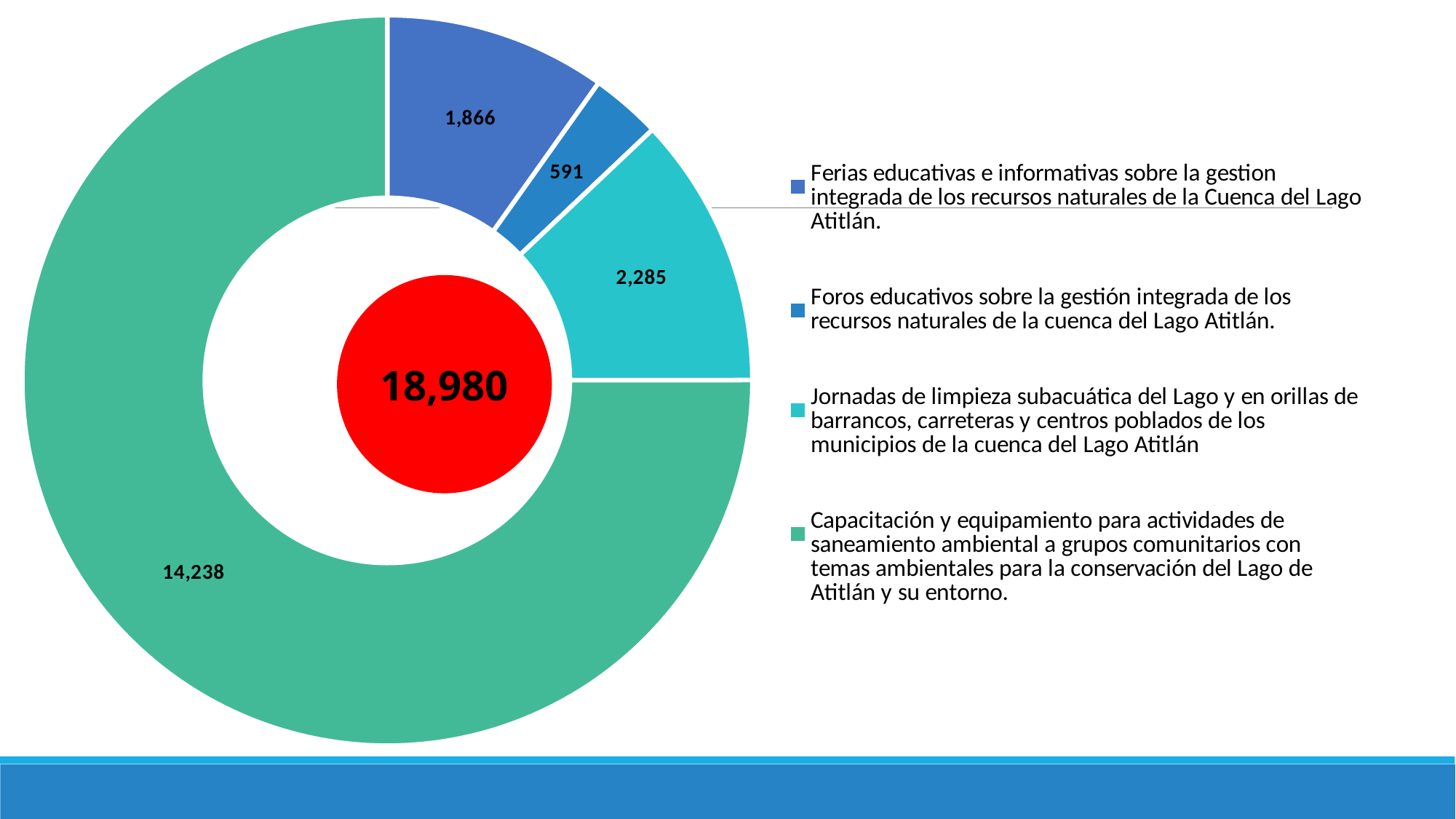
Which category has the smallest slice of the doughnut? Foros educativos sobre la gestión integrada de los recursos naturales de la cuenca del Lago Atitlán. Which is larger: the value for Jornadas de limpieza or the value for Ferias educativas? Jornadas de limpieza What is the value for Ferias educativas e informativas sobre la gestion integrada de los recursos naturales? 1,866 What is the difference between the value for Ferias educativas and the value for Foros educativos? 1,275 What is the value for Capacitación y equipamiento para actividades de saneamiento ambiental a grupos comunitarios? 14,238 How many categories does the doughnut chart show? 4 What kind of chart is shown on the slide? Doughnut chart What is the value for Foros educativos sobre la gestión integrada de los recursos naturales? 591 What total is shown in the red circle at the centre of the chart? 18,980 Which category has the largest slice of the doughnut? Capacitación y equipamiento para actividades de saneamiento ambiental a grupos comunitarios con temas ambientales para la conservación del Lago de Atitlán y su entorno. What is the difference between the value for Capacitación y equipamiento (14,238) and the value for Jornadas de limpieza (2,285)? 11,953 What is the value for Jornadas de limpieza subacuática del Lago y en orillas de barrancos, carreteras y centros poblados? 2,285